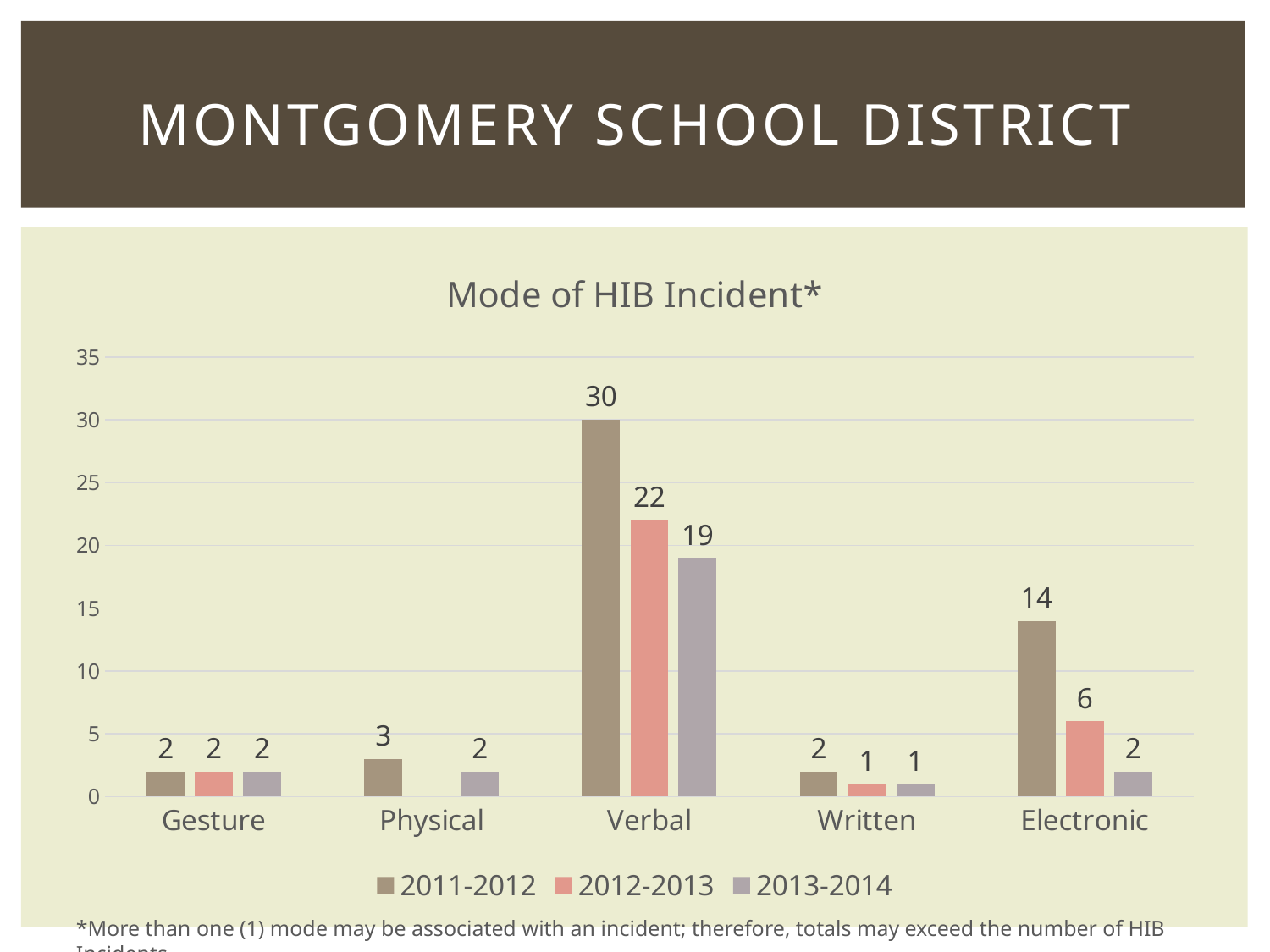
How many categories are shown on the x axis? 5 Do the values for Verbal rise or fall from 2011-2012 to 2013-2014? Fall Which is larger: the 2011-2012 value for Electronic or the 2012-2013 value for Verbal? 2012-2013 value for Verbal How many series does the legend list? 3 What is the value for Electronic in the 2012-2013 series? 6 What is the value for Physical in the 2011-2012 series? 3 What is the difference between the 2011-2012 and 2013-2014 values for Verbal? 11 Which category has the highest value in the 2013-2014 series? Verbal What kind of chart is shown on the slide? Bar chart What is the title of the chart? Mode of HIB Incident* What is the value for Verbal in the 2011-2012 series? 30